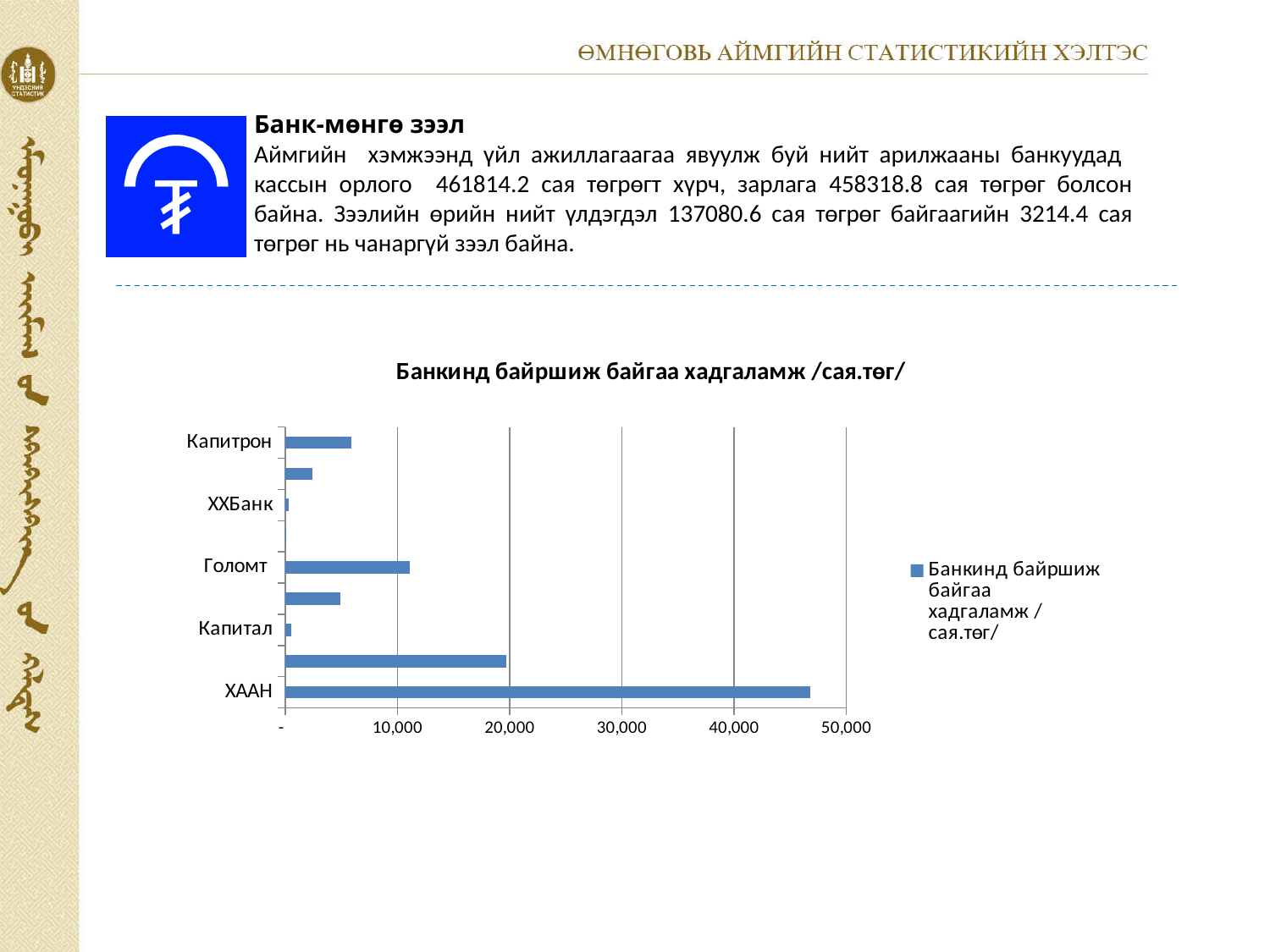
Is the value for Голомт greater or less than 10,000? greater How many series does the chart legend list? 1 Is the value for ХААН greater or less than 40,000? greater What is the title of the chart? Банкинд байршиж байгаа хадгаламж /сая.төг/ What colour are the bars in the chart? blue Is the value for Капитал greater or less than 10,000? less Which bank has the highest value in the chart? ХААН What kind of chart is shown on the slide? bar chart Which is larger, the value for ХААН or the value for Голомт? ХААН Which is larger, the value for Голомт or the value for Капитрон? Голомт